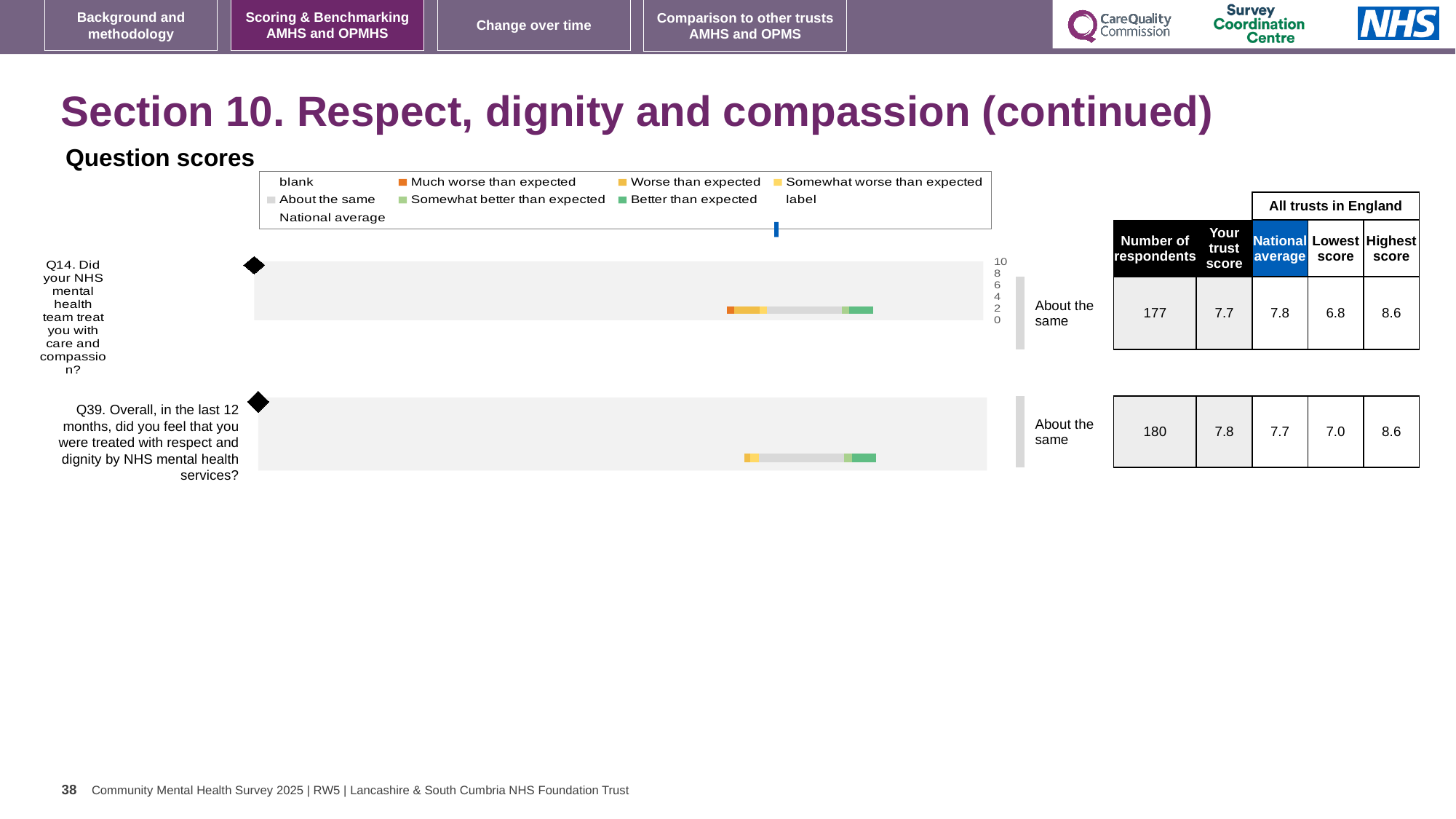
What is the trust score for Q14 (care and compassion)? 7.7 How many questions are plotted in the chart? 2 What is the national average for Q14? 7.8 What is the highest score across all trusts in England for Q39? 8.6 What is the difference between the highest score and the lowest score for Q14? 1.8 What is the lowest score across all trusts in England for Q14? 6.8 What type of chart is used to show the question scores? Bar chart What benchmark category is shown next to both Q14 and Q39? About the same What is the trust score for Q39 (treated with respect and dignity)? 7.8 What is the number of respondents for Q39? 180 What is the difference between the number of respondents for Q39 and Q14? 3 Which question has the higher trust score, Q14 or Q39? Q39